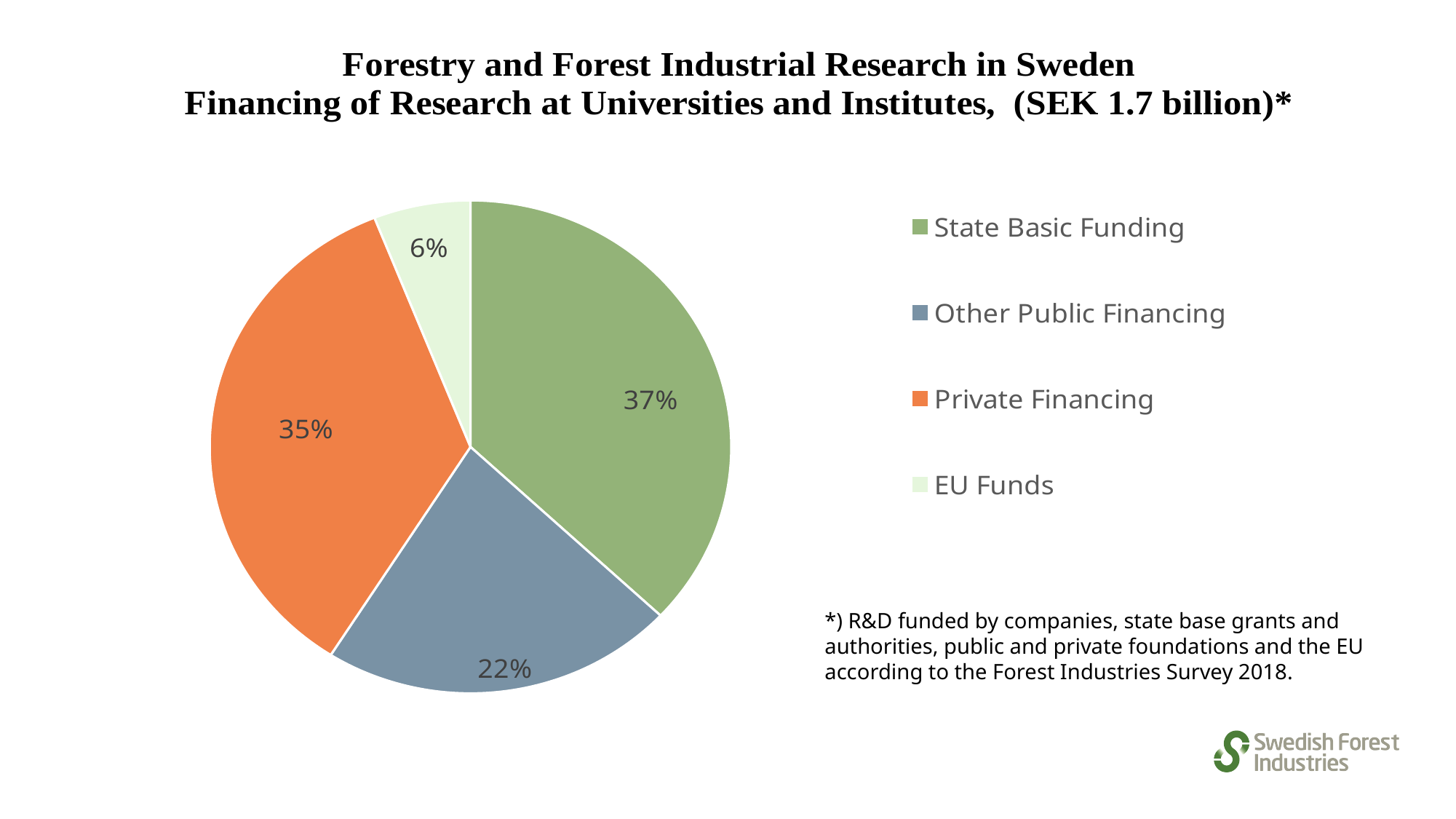
Which category has the largest share of the pie? State Basic Funding Which category has the smallest share of the pie? EU Funds What share of the pie does Other Public Financing represent? 22% What share of the pie does Private Financing represent? 35% What share of the pie does State Basic Funding represent? 37% What total amount of financing is stated in the chart title? SEK 1.7 billion What is the difference in percentage points between Private Financing and Other Public Financing? 13 How many categories are shown in the pie chart? 4 What colour is the slice for Private Financing? Orange What share of the pie does EU Funds represent? 6% Which is larger, the share for Other Public Financing or the share for EU Funds? Other Public Financing What kind of chart is shown on the slide? Pie chart